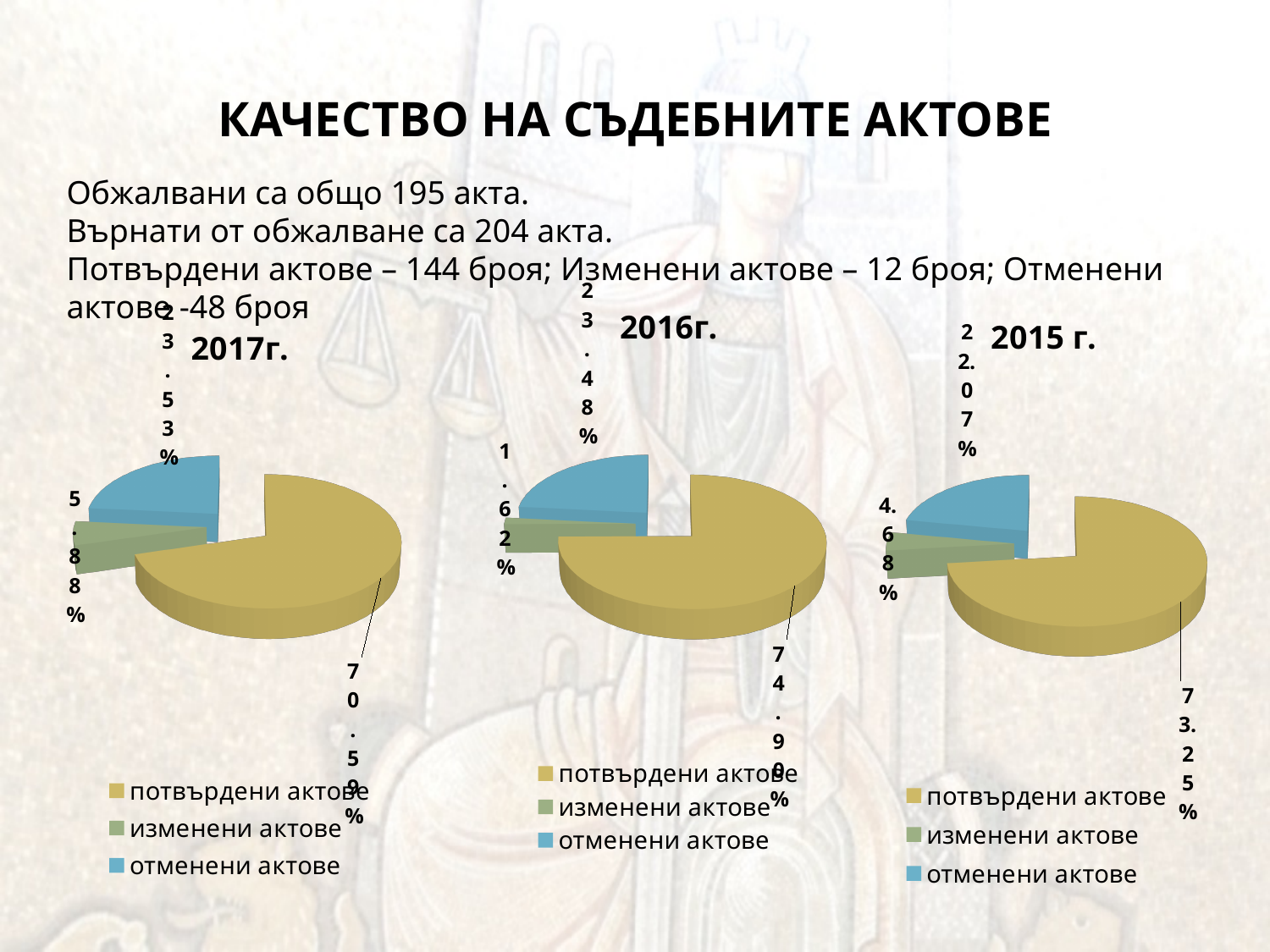
In the 2015 г. chart, what share do отменени актове have? 22.07% In the 2015 г. chart, what share do потвърдени актове have? 73.25% In the 2017г. chart, what share do потвърдени актове have? 70.59% In the 2017г. chart, what share do изменени актове have? 5.88% In the 2016г. chart, what share do изменени актове have? 1.62% In the 2015 г. chart, which category has the smallest slice? изменени актове How many categories does the legend of the 2017г. chart list? 3 In the 2016г. chart, what share do отменени актове have? 23.48% How many charts are shown on the slide? 3 What kind of chart is used for the 2017г. chart? pie chart In the 2017г. chart, which is larger: the share of изменени актове or the share of отменени актове? отменени актове In the 2016г. chart, which category has the largest slice? потвърдени актове